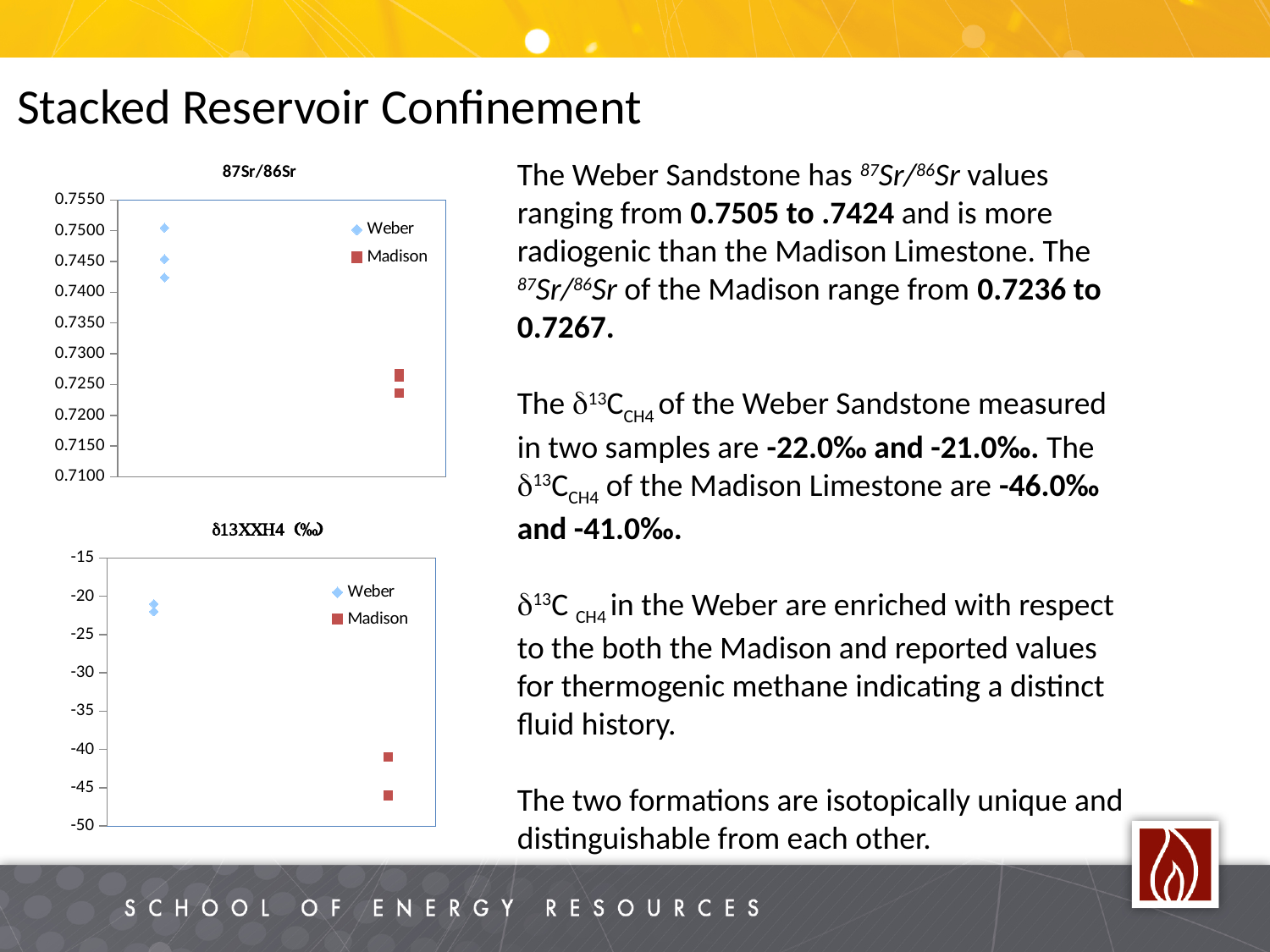
In the top chart (87Sr/86Sr), are the Weber values greater or less than 0.7400? greater In the bottom chart (δ13CCH4), are the Weber values greater or less than -25? greater In the bottom chart (δ13CCH4), are the Madison values greater or less than -40? less In the top chart (87Sr/86Sr), how many Weber data points are plotted? 3 In the top chart (87Sr/86Sr), how many series does the legend list? 2 In the top chart (87Sr/86Sr), which series has the higher values, Weber or Madison? Weber In the bottom chart (δ13CCH4), which series has the higher (less negative) values, Weber or Madison? Weber What kind of chart is the bottom chart titled δ13CCH4 (‰)? scatter chart What kind of chart is the top chart titled 87Sr/86Sr? scatter chart In the bottom chart (δ13CCH4), what are the two legend entries? Weber and Madison